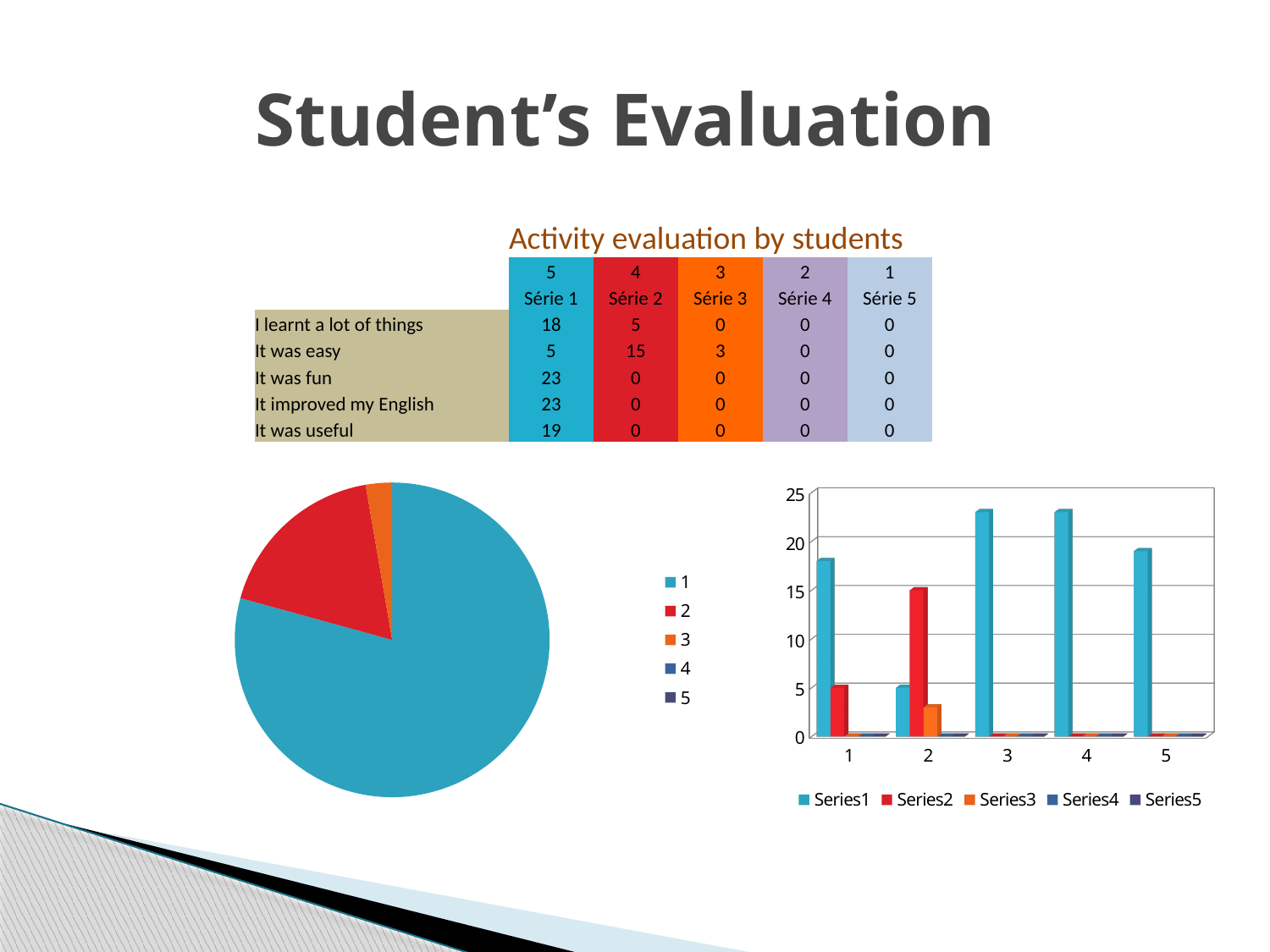
In the pie chart, how many entries does the legend list? 5 In the bar chart, what is the value of Series2 for category 2? 15 What type of chart is shown on the left side of the slide, below the table? pie chart In the bar chart, for category 2, which is larger: Series1 or Series2? Series2 What type of chart is shown on the right side of the slide? bar chart In the bar chart, for which category is the Series1 bar the lowest? 2 In the bar chart, how many categories are shown on the x axis? 5 In the bar chart, is the value of Series1 for category 1 greater or less than 20? less In the bar chart, what is the value of Series1 for category 2? 5 In the bar chart, is the value of Series1 for category 3 greater or less than 20? greater In the pie chart, which legend entry corresponds to the largest slice? 1 In the bar chart, how many series does the legend list? 5